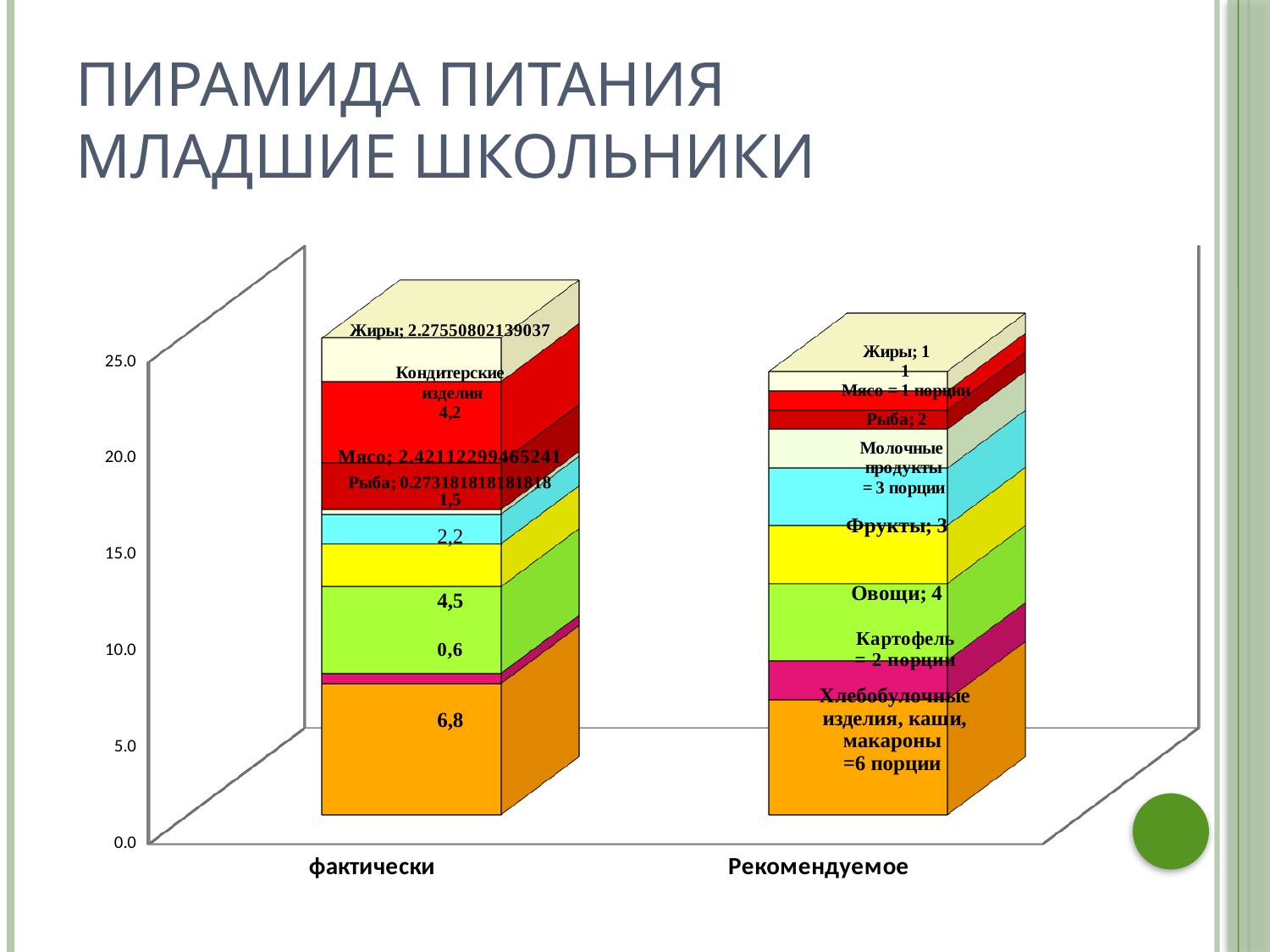
How many bars (categories) are plotted on the x axis? 2 What value is printed for 'Фрукты' in the 'Рекомендуемое' bar? 3 What kind of chart is shown on the slide? stacked bar chart What value is printed for 'Кондитерские изделия' in the 'фактически' bar? 4,2 What value is printed for 'Овощи' in the 'Рекомендуемое' bar? 4 How many portions of 'Хлебобулочные изделия, каши, макароны' are shown in the 'Рекомендуемое' bar? 6 порции In the 'Рекомендуемое' bar, what is the difference between the values for 'Овощи' and 'Фрукты'? 1 What is the value of the bottom (orange) segment of the 'фактически' bar? 6,8 What value is printed for 'Рыба' in the 'Рекомендуемое' bar? 2 What are the two category labels on the x axis? фактически and Рекомендуемое Is the total height of the 'Рекомендуемое' bar greater or less than 20? greater